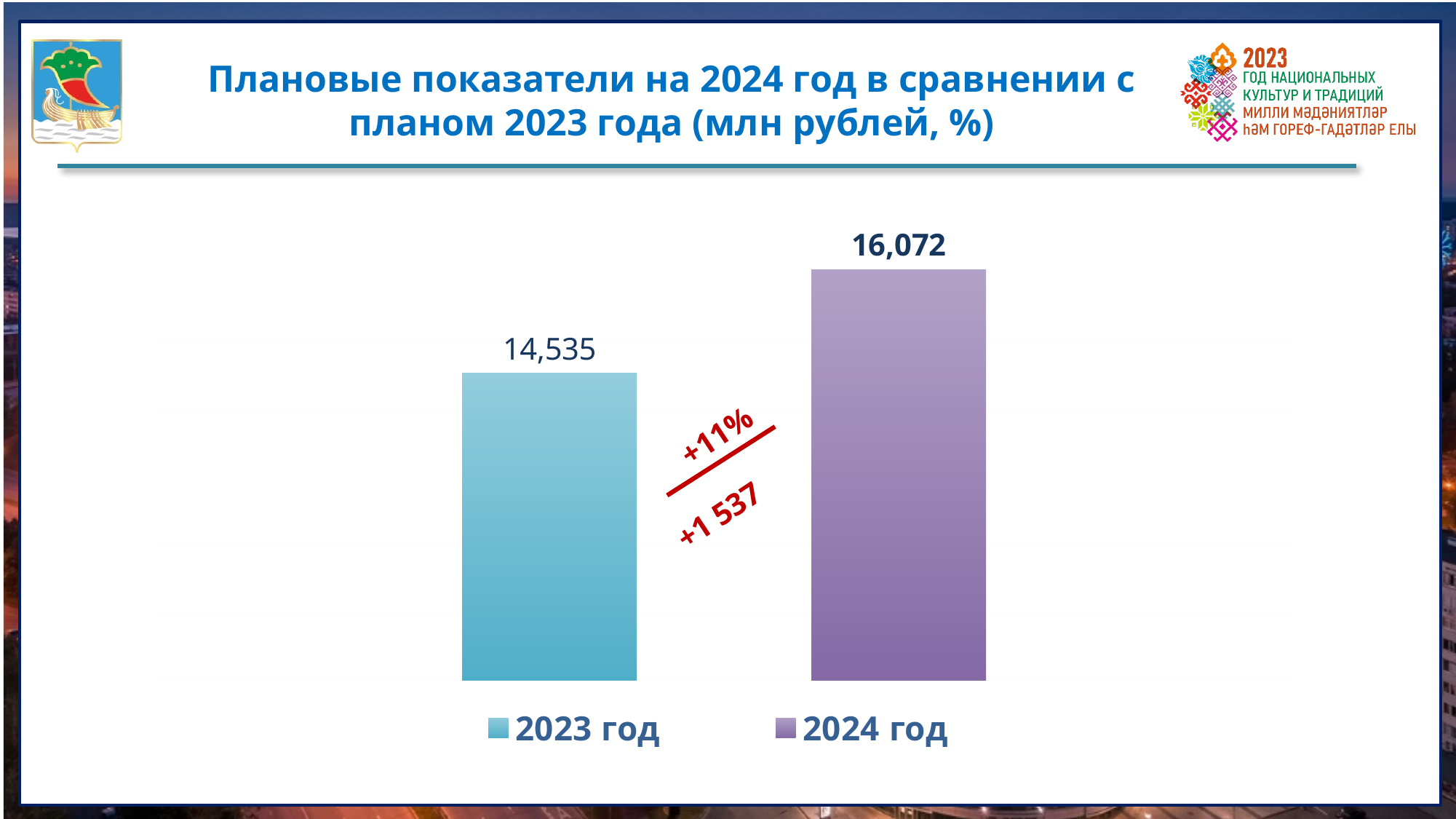
What is the difference between the 2024 год value and the 2023 год value? 1,537 How many bars are plotted in the chart? 2 Which bar is the tallest in the chart? 2024 год What colour is the bar for 2024 год? Purple What percentage change is annotated between the two bars? +11% How many entries does the legend list? 2 Which year has the higher value, 2023 год or 2024 год? 2024 год What is the value shown for 2023 год? 14,535 Which bar is the shortest in the chart? 2023 год Do the values rise or fall from 2023 год to 2024 год? Rise What is the value shown for 2024 год? 16,072 What type of chart is shown on the slide? Bar chart